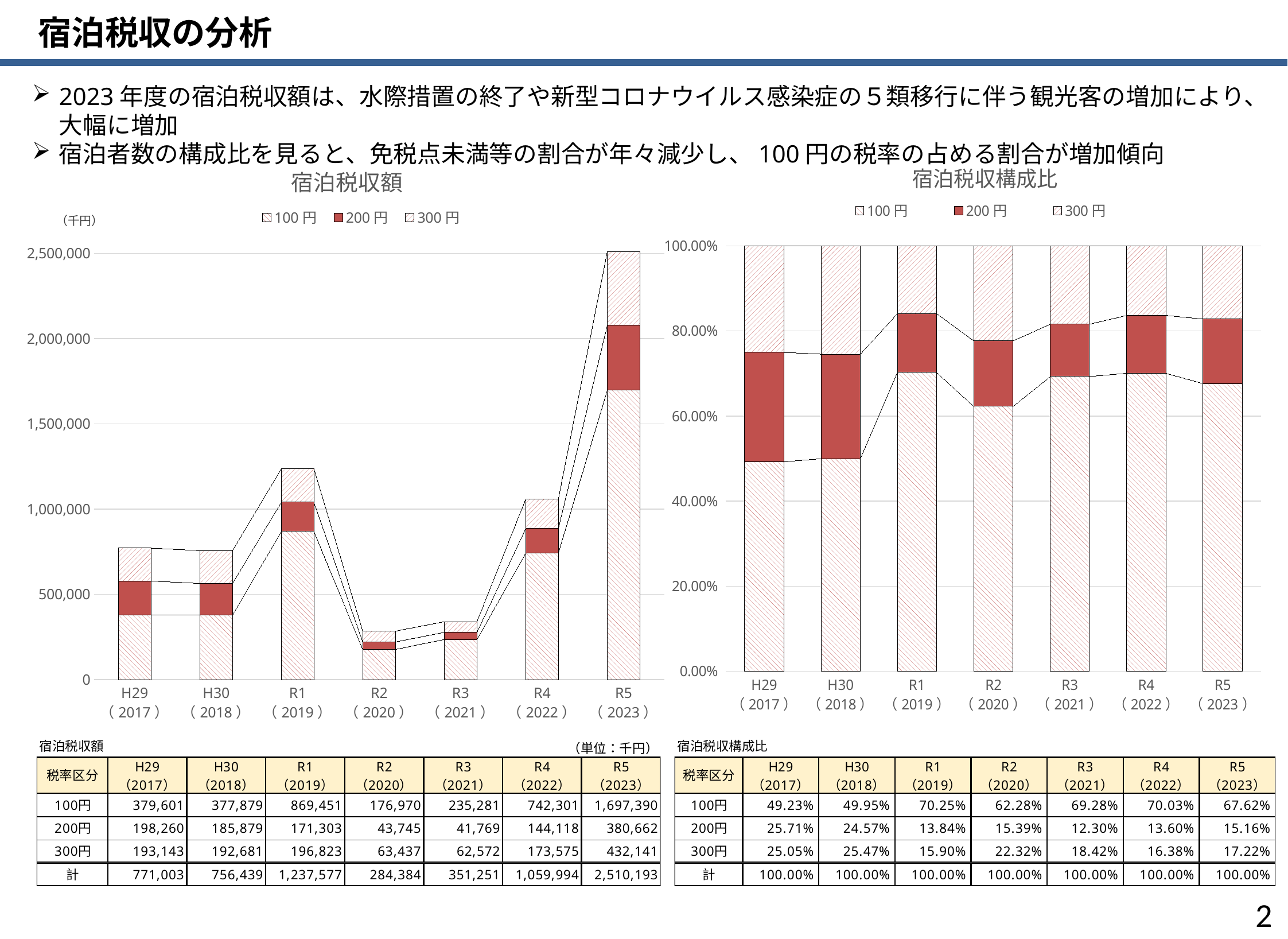
In the 宿泊税収額 chart on the left, what is the difference between the 300円 values for R5 (2023) and R4 (2022)? 258,566 In the 宿泊税収構成比 chart on the right, is the 100円 share for H29 (2017) larger or smaller than that for R5 (2023)? smaller In the 宿泊税収額 chart on the left, how many years are shown on the x axis? 7 In the 宿泊税収額 chart on the left, which year has the highest total stacked bar? R5 (2023) In the 宿泊税収額 chart on the left, which year has the lowest total stacked bar? R2 (2020) In the 宿泊税収額 chart on the left, what is the value for 100円 in R5 (2023)? 1,697,390 In the 宿泊税収構成比 chart on the right, which year has the lowest share for 200円? R3 (2021) In the 宿泊税収構成比 chart on the right, what is the share of 100円 in R1 (2019)? 70.25% In the 宿泊税収額 chart on the left, what is the total of the stacked bar for R1 (2019)? 1,237,577 How many series does the legend of the 宿泊税収構成比 chart on the right list? 3 What kind of chart is the 宿泊税収額 chart on the left? Stacked bar chart In the 宿泊税収額 chart on the left, is the total for R4 (2022) greater or less than 1,000,000? greater